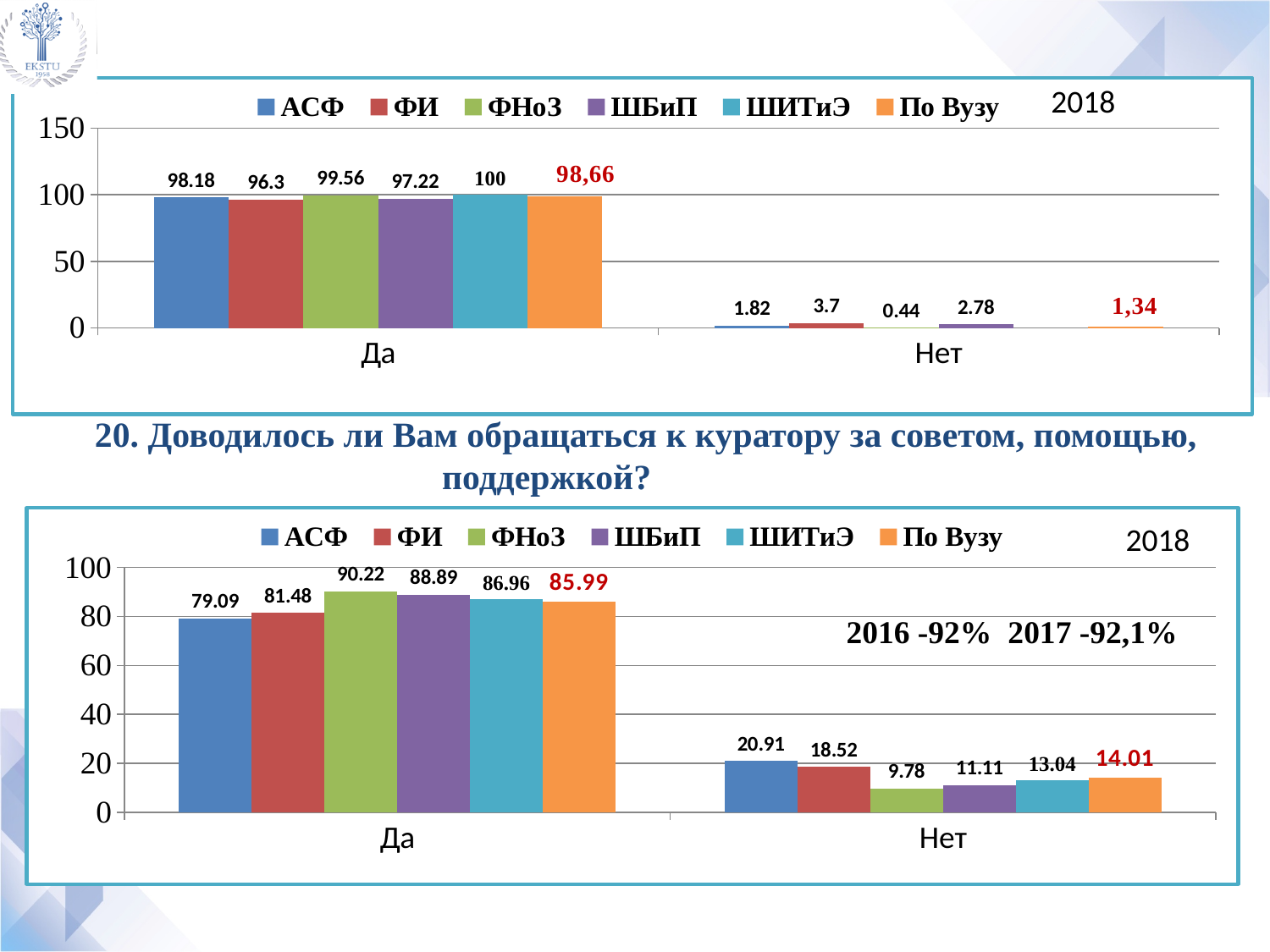
In the bottom chart, which series has the highest value in the Да category? ФНоЗ In the bottom chart, which series has the lowest value in the Нет category? ФНоЗ In the bottom chart, which is larger in the Да category: ШБиП or ШИТиЭ? ШБиП In the bottom chart, what is the difference between the Нет values for АСФ and ФИ? 2.39 How many series does the legend of the bottom chart list? 6 In the bottom chart, what is the value for По Вузу in the Нет category? 14.01 In the top chart, what is the value for ШИТиЭ in the Да category? 100 In the bottom chart, what is the value for АСФ in the Да category? 79.09 In the top chart, which series has the highest value in the Нет category? ФИ What type of chart is the bottom chart? Bar chart In the top chart, what is the value for ФНоЗ in the Нет category? 0.44 How many categories are shown on the x axis of the top chart? 2